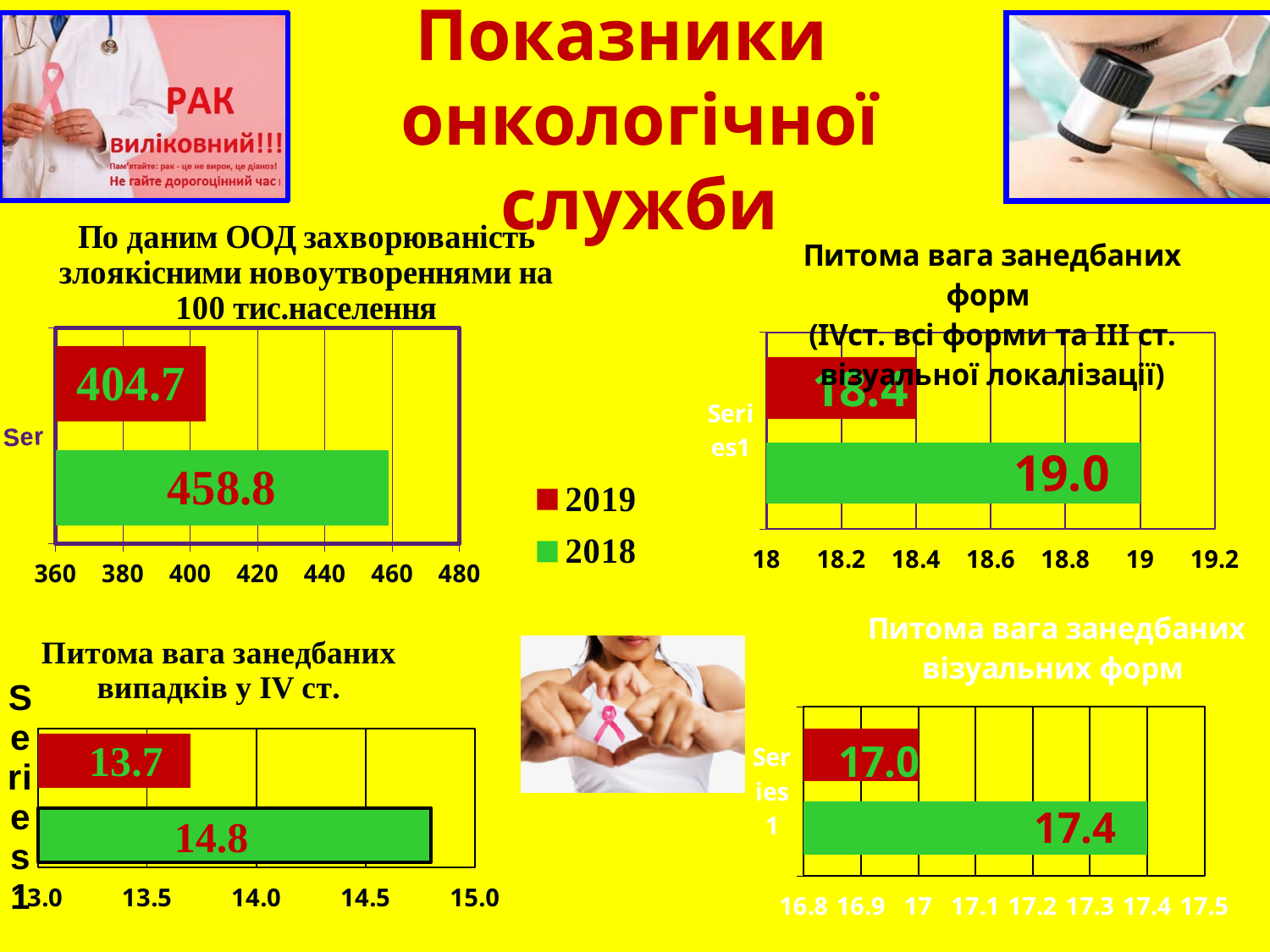
In the bottom-left chart (Питома вага занедбаних випадків у IV ст.), what is the value of the green bar? 14.8 How many entries does the legend next to the top-left chart list? 2 In the top-right chart (Питома вага занедбаних форм), what is the value of the green bar? 19.0 In the top-right chart (Питома вага занедбаних форм), what is the value of the red bar? 18.4 In the bottom-right chart (Питома вага занедбаних візуальних форм), what is the value of the red bar? 17.0 According to the legend next to the top-left chart, which year does the red colour represent? 2019 In the top-left chart (захворюваність на 100 тис.населення), which bar is longer, the red one or the green one? the green one In the top-left chart (захворюваність на 100 тис.населення), what is the difference between the green bar and the red bar? 54.1 In the top-left chart (захворюваність на 100 тис.населення), what is the value of the green bar? 458.8 What kind of chart is the top-left chart (захворюваність на 100 тис.населення)? bar chart In the top-left chart (захворюваність на 100 тис.населення), what is the value of the red bar? 404.7 In the bottom-left chart (Питома вага занедбаних випадків у IV ст.), what is the difference between the green bar and the red bar? 1.1